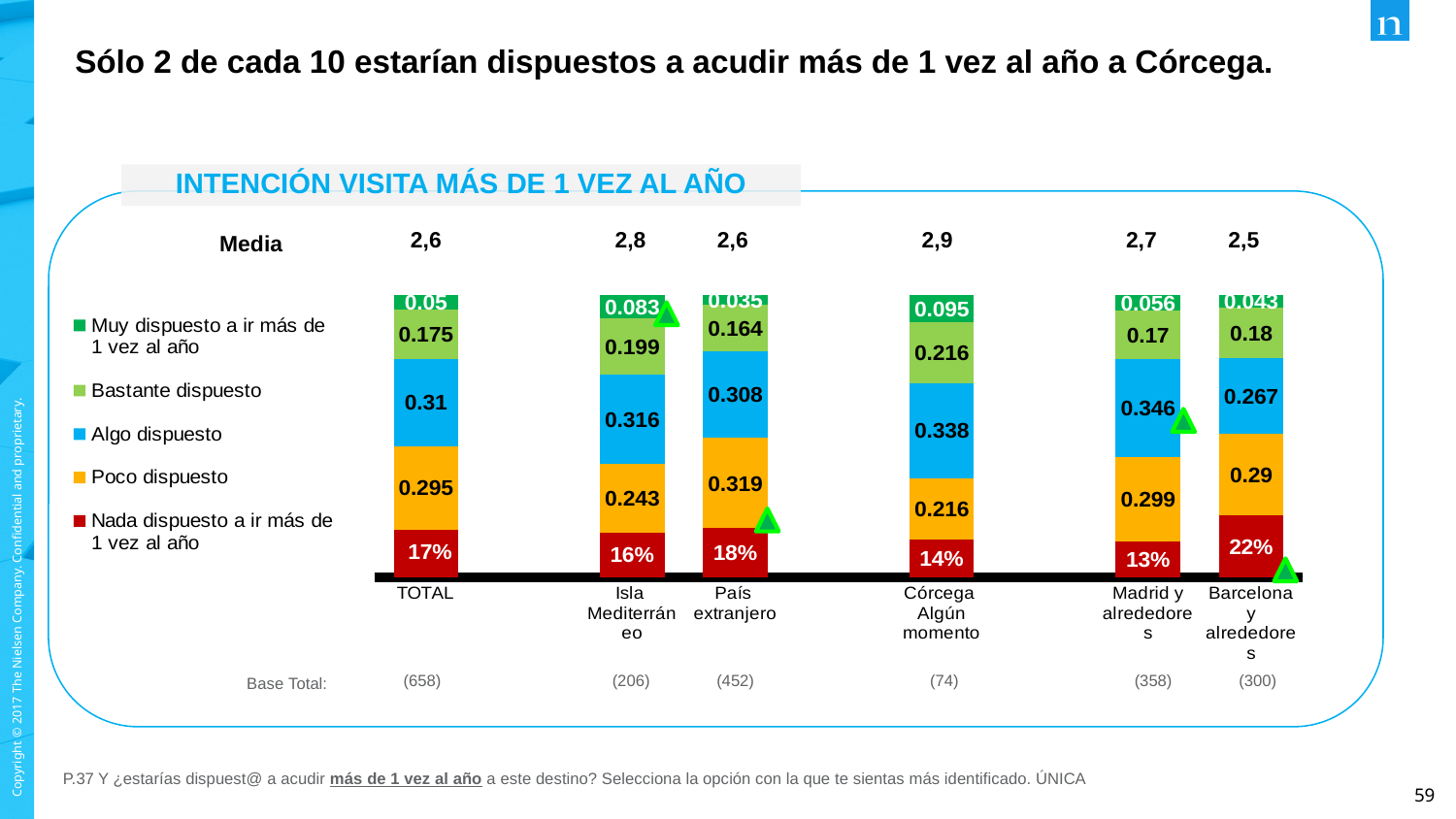
What is the value of the "Nada dispuesto a ir más de 1 vez al año" segment for Barcelona y alrededores? 22% How many categories are shown on the x axis of the chart? 6 Which is larger, the "Bastante dispuesto" value for Córcega Algún momento or for TOTAL? Córcega Algún momento Which category has the highest value for "Nada dispuesto a ir más de 1 vez al año"? Barcelona y alrededores What is the value of the "Algo dispuesto" segment for Córcega Algún momento? 0.338 How many series does the legend list? 5 Which category has the lowest value for "Nada dispuesto a ir más de 1 vez al año"? Madrid y alrededores What kind of chart is shown on the slide? Stacked bar chart What is the difference between the "Algo dispuesto" values for Madrid y alrededores and Barcelona y alrededores? 0.079 What is the value of the "Muy dispuesto a ir más de 1 vez al año" segment for Isla Mediterráneo? 0.083 What is the title shown above the chart? INTENCIÓN VISITA MÁS DE 1 VEZ AL AÑO What is the value of the "Poco dispuesto" segment for País extranjero? 0.319